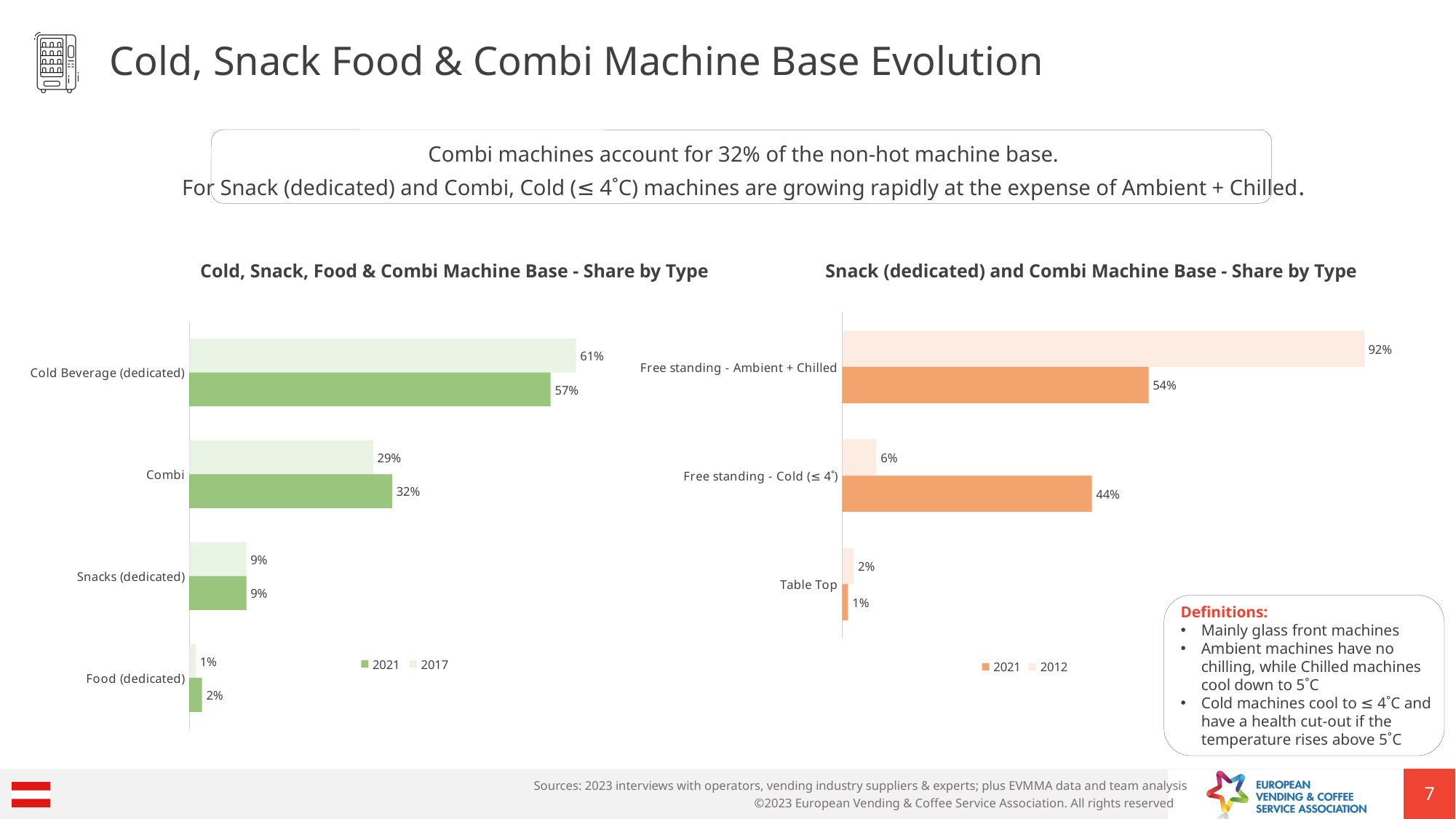
In the 'Snack (dedicated) and Combi Machine Base - Share by Type' chart, what is the 2021 value for Free standing - Cold (≤ 4˚)? 44% What type of chart is the 'Snack (dedicated) and Combi Machine Base - Share by Type' chart? Bar chart In the 'Cold, Snack, Food & Combi Machine Base - Share by Type' chart, what is the difference between the 2017 and 2021 values for Cold Beverage (dedicated)? 4% In the 'Snack (dedicated) and Combi Machine Base - Share by Type' chart, what is the 2012 value for Free standing - Ambient + Chilled? 92% In the 'Cold, Snack, Food & Combi Machine Base - Share by Type' chart, what is the 2021 value for Combi? 32% In the 'Cold, Snack, Food & Combi Machine Base - Share by Type' chart, how many categories are shown? 4 In the 'Snack (dedicated) and Combi Machine Base - Share by Type' chart, how many series does the legend list? 2 In the 'Cold, Snack, Food & Combi Machine Base - Share by Type' chart, what is the 2017 value for Cold Beverage (dedicated)? 61% In the 'Snack (dedicated) and Combi Machine Base - Share by Type' chart, what is the difference between the 2012 and 2021 values for Free standing - Ambient + Chilled? 38% In the 'Snack (dedicated) and Combi Machine Base - Share by Type' chart, which is larger for Table Top: the 2021 value or the 2012 value? 2012 In the 'Cold, Snack, Food & Combi Machine Base - Share by Type' chart, which category has the lowest 2017 value? Food (dedicated) In the 'Cold, Snack, Food & Combi Machine Base - Share by Type' chart, which category has the highest 2021 value? Cold Beverage (dedicated)